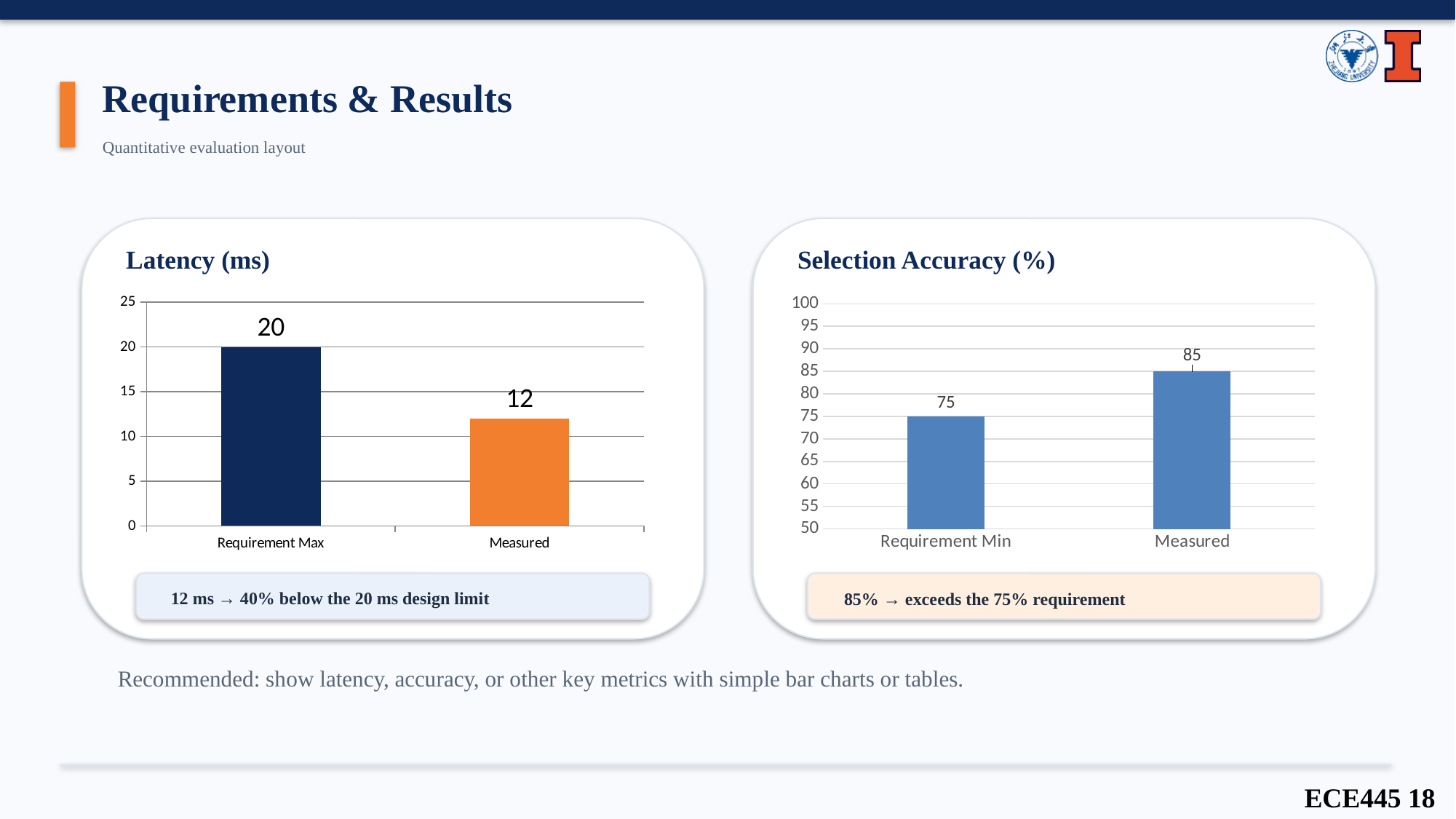
In the Latency (ms) chart, how many categories are shown? 2 In the Latency (ms) chart, what is the value for Measured? 12 What kind of chart is the Latency (ms) chart? Bar chart In the Selection Accuracy (%) chart, which category has the highest value? Measured In the Latency (ms) chart, which category has the lowest value? Measured In the Selection Accuracy (%) chart, what is the value for Requirement Min? 75 In the Selection Accuracy (%) chart, what is the difference between Measured and Requirement Min? 10 In the Selection Accuracy (%) chart, is the value for Measured greater or less than 80? greater In the Latency (ms) chart, what colour is the Measured bar? Orange In the Latency (ms) chart, what is the value for Requirement Max? 20 In the Latency (ms) chart, what is the difference between Requirement Max and Measured? 8 In the Selection Accuracy (%) chart, what is the value for Measured? 85